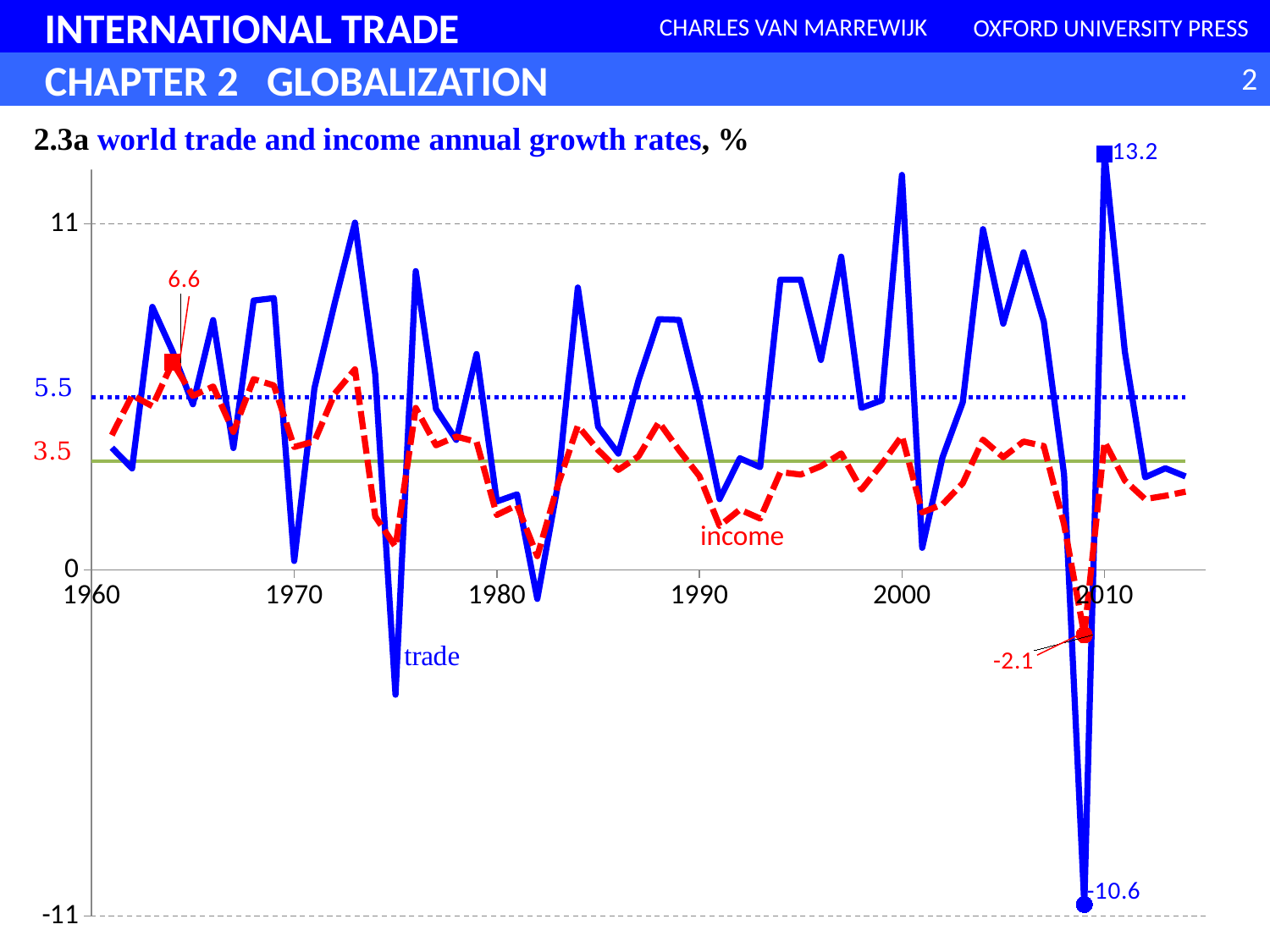
Which series reaches the highest value in the chart? trade How many data series are plotted in the chart? 4 In 2009, which series fell further: trade or income? trade What is the highest labelled value of the trade series? 13.2 What value is marked by the blue dotted horizontal line? 5.5 What is the difference between the highest labelled trade value (13.2) and the lowest labelled trade value (-10.6)? 23.8 What is the labelled value of the income series in the early 1960s peak? 6.6 Is the value for trade in 1975 greater or less than 0? less What is the labelled value of the income series at its 2009 low point? -2.1 What kind of chart is shown on the slide? line chart What is the lowest labelled value of the trade series? -10.6 What is the title of the chart? 2.3a world trade and income annual growth rates, %